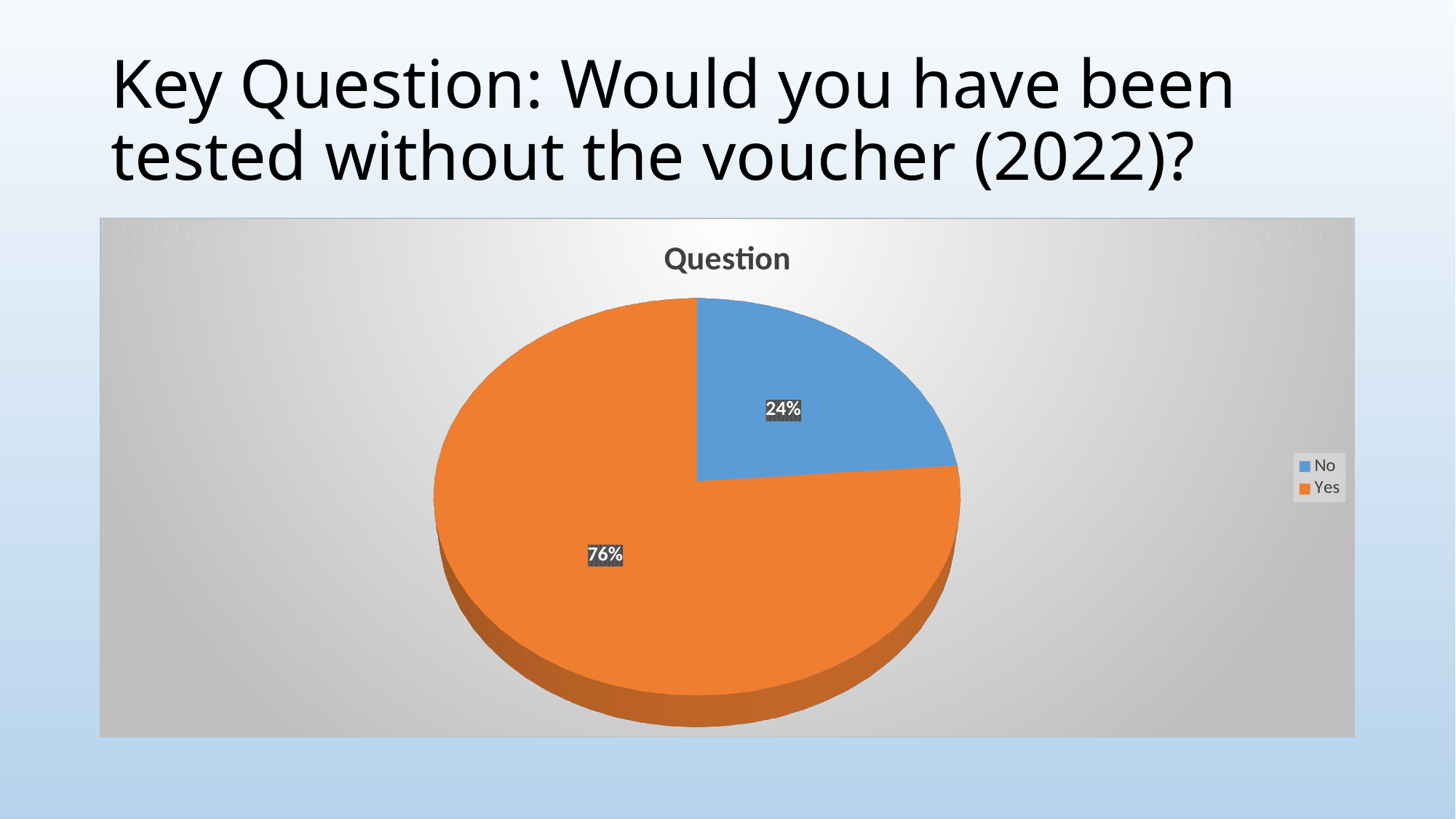
Which slice is larger, "Yes" or "No"? Yes How many slices does the pie chart have? 2 What colour is the "No" slice? Blue What percentage of the pie is labelled "No"? 24% Which slice is the largest? Yes What type of chart is shown on the slide? Pie chart What share of the pie does the "Yes" slice represent? 76% What is the title of the chart? Question Which slice is the smallest? No What is the difference in percentage points between the "Yes" and "No" slices? 52 How many entries does the legend list? 2 What percentage of the pie is labelled "Yes"? 76%